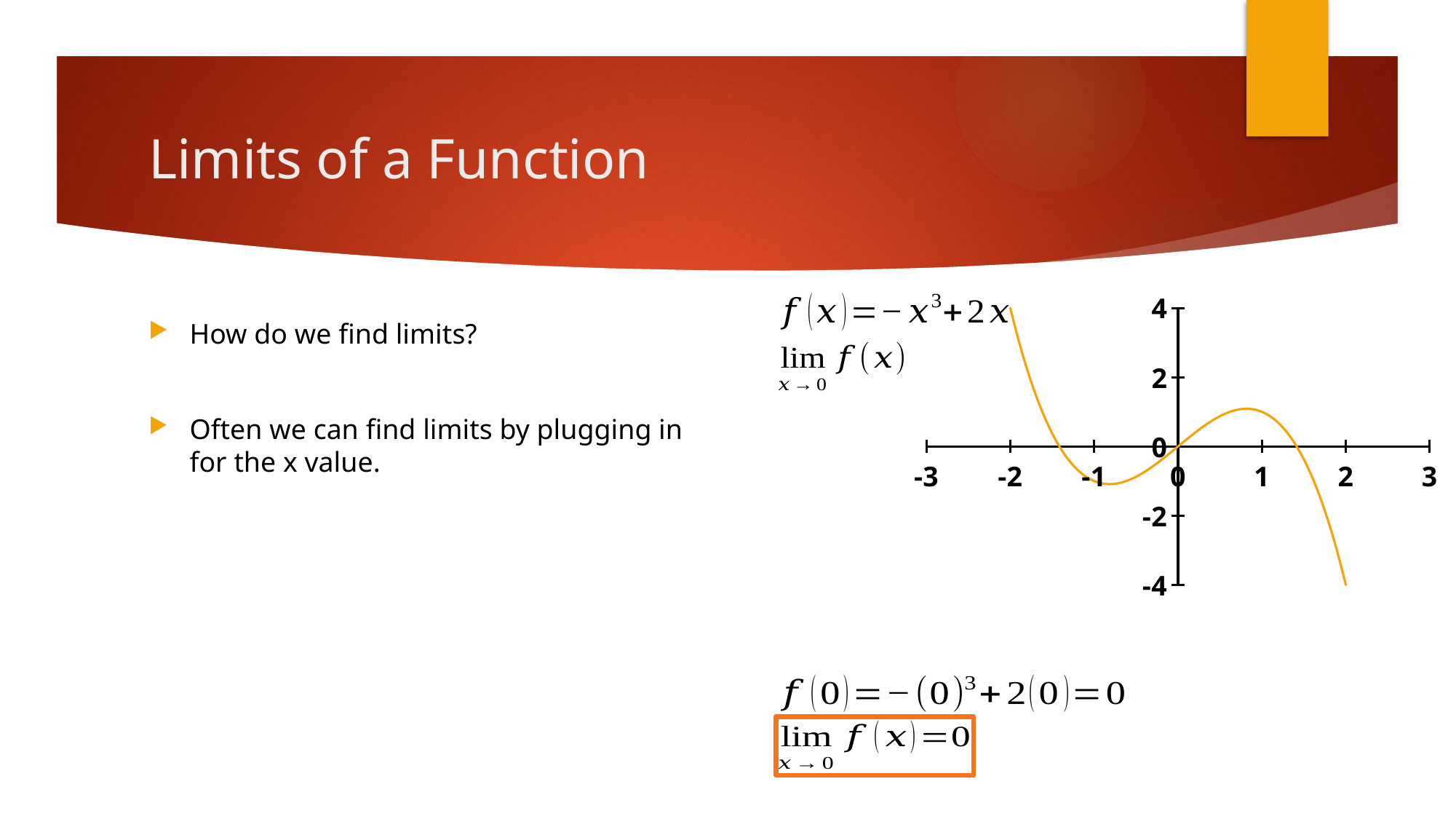
Does the curve rise or fall as x goes from 1 to 2? fall What is the value of the curve at x = 2? -4 What colour is the plotted curve? orange Does the curve rise or fall as x goes from 0 to 1? rise Is the value of the curve at x = -1 greater or less than 0? less What kind of chart is shown on the right of the slide? line chart What is the value of the limit of f(x) as x approaches 0, as shown in the boxed result? 0 What function is plotted on the chart? f(x) = -x^3 + 2x Is the value of the curve at x = 1 greater or less than 0? greater What is the value of the curve at x = -2? 4 What is the value of f(x) at x = 0 according to the slide? 0 How many labelled tick marks are on the x axis? 7